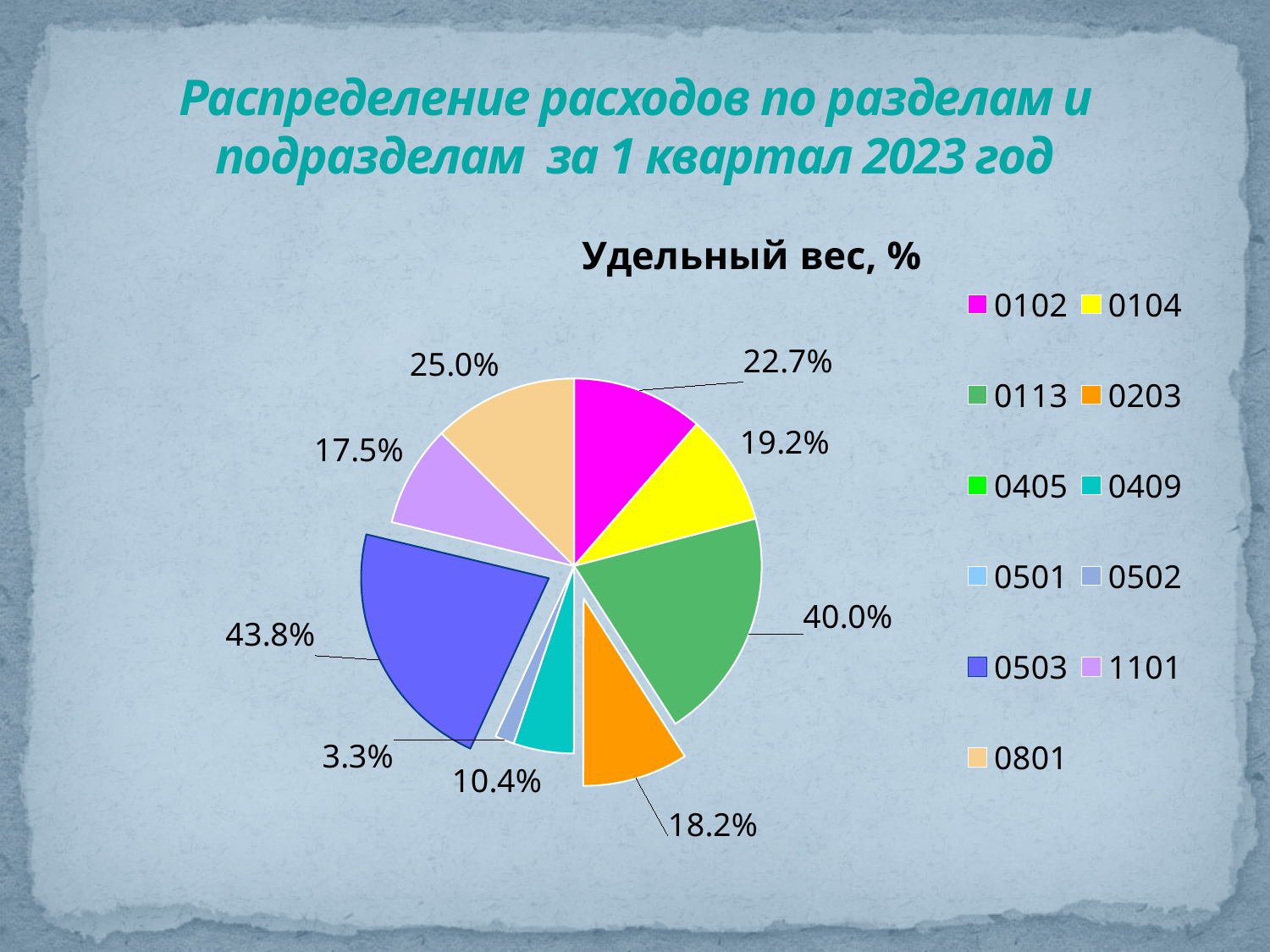
What kind of chart is shown on the slide? pie chart What is the title of the chart? Удельный вес, % Which is larger, the value for 1101 or the value for 0801? 0801 Which labelled category has the smallest slice in the pie chart? 0502 Which category has the largest slice in the pie chart? 0503 How many entries does the chart legend list? 11 What is the value shown for category 0409? 10.4% What is the value shown for category 0801? 25.0% What is the value shown for category 0503? 43.8% What is the difference between the values for 0104 and 0203? 1.0% What is the value shown for category 0102? 22.7% What is the value shown for category 0113? 40.0%